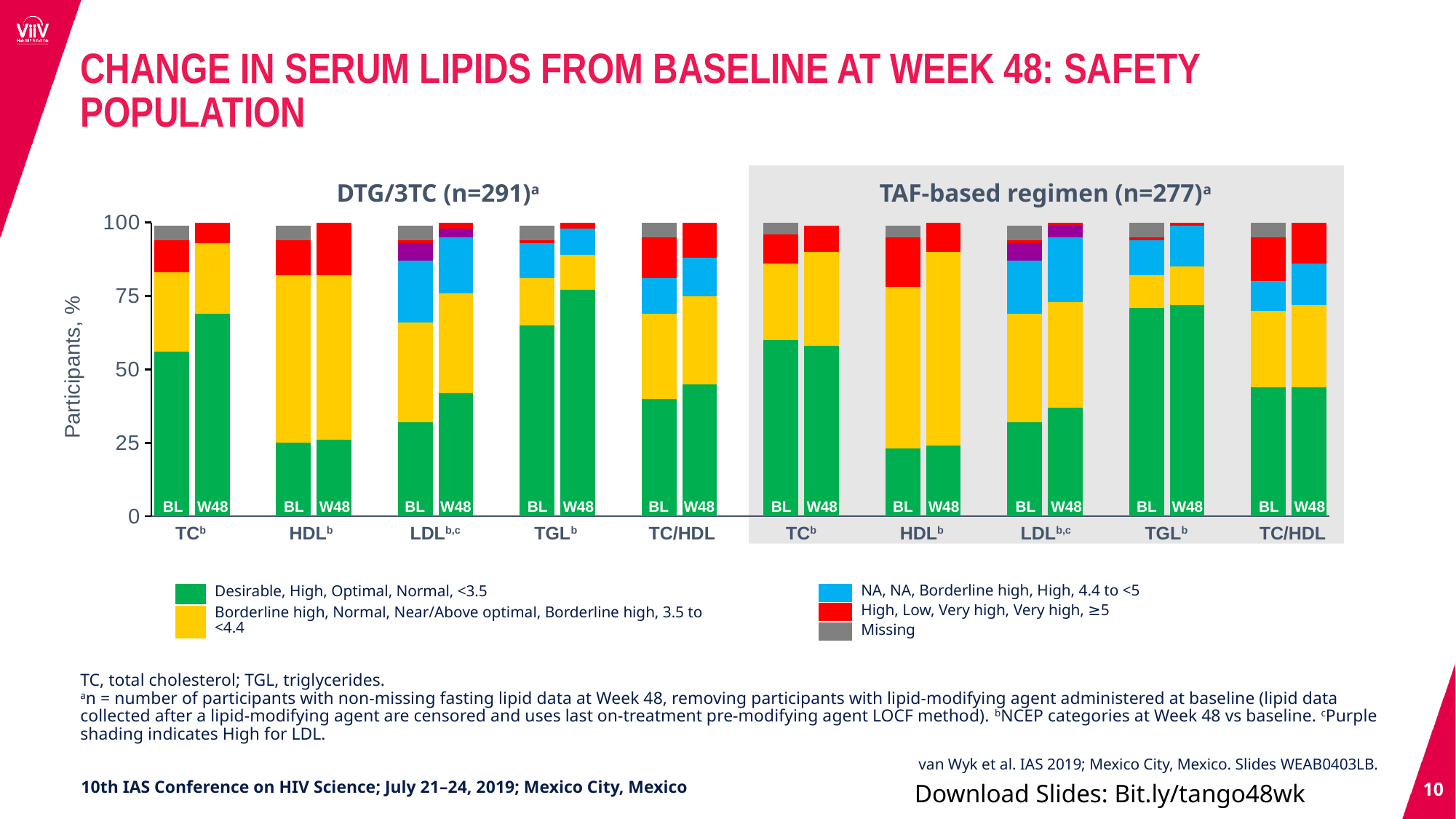
In the DTG/3TC group, which TC bar has the larger green (Desirable) segment, BL or W48? W48 In the TAF-based regimen group, is the green (Desirable) segment of the TC/HDL BL bar greater or less than 50? less In the TAF-based regimen group, is the green (Desirable) segment of the TGL BL bar greater or less than 50? greater In the DTG/3TC group, is the green (Desirable) segment of the TC/HDL BL bar greater or less than 50? less How many entries does the legend list? 5 What kind of chart is shown on the slide? Stacked bar chart Which colour represents the 'Missing' category in the legend? Grey How many lipid categories are labelled on the x axis across both regimens? 10 Which has the larger green (Desirable) segment: the DTG/3TC TC BL bar or the TAF-based regimen HDL BL bar? DTG/3TC TC BL How many bars are plotted in the DTG/3TC (n=291) group? 10 What is the label of the y axis? Participants, %